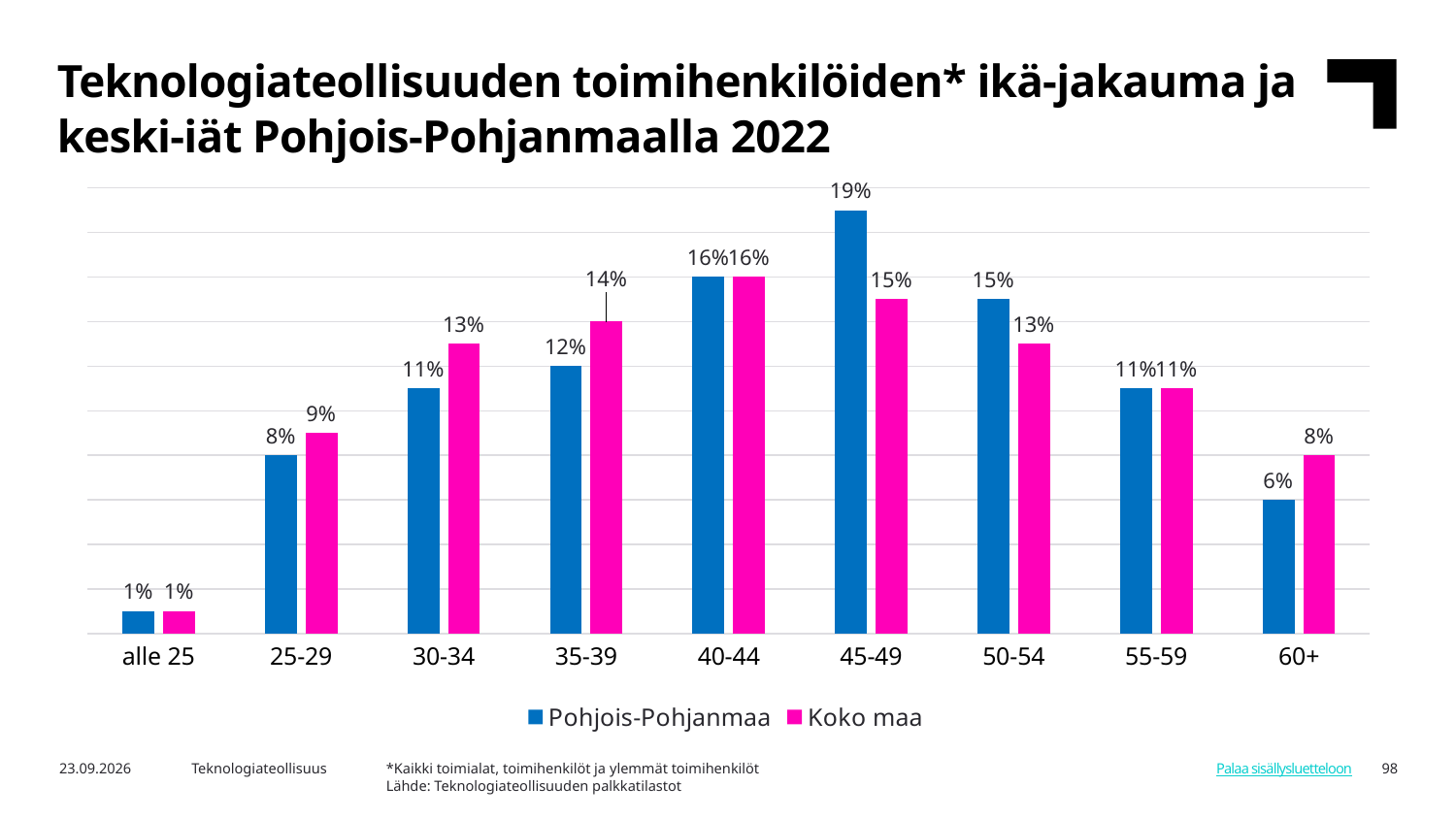
What is the value for Koko maa in the 35-39 age group? 14% In the 30-34 age group, which series has the larger value, Pohjois-Pohjanmaa or Koko maa? Koko maa Do the Pohjois-Pohjanmaa values rise or fall from the 45-49 age group to the 60+ age group? fall What kind of chart is shown on the slide? bar chart What is the value for Pohjois-Pohjanmaa in the 45-49 age group? 19% What is the value for Koko maa in the 60+ age group? 8% What is the difference between Pohjois-Pohjanmaa and Koko maa in the 45-49 age group? 4 percentage points How many age categories are shown on the x axis? 9 How many series does the legend list? 2 Which colour represents the Koko maa series in the legend? pink Which age group has the lowest value for Koko maa? alle 25 Which age group has the highest value for Pohjois-Pohjanmaa? 45-49